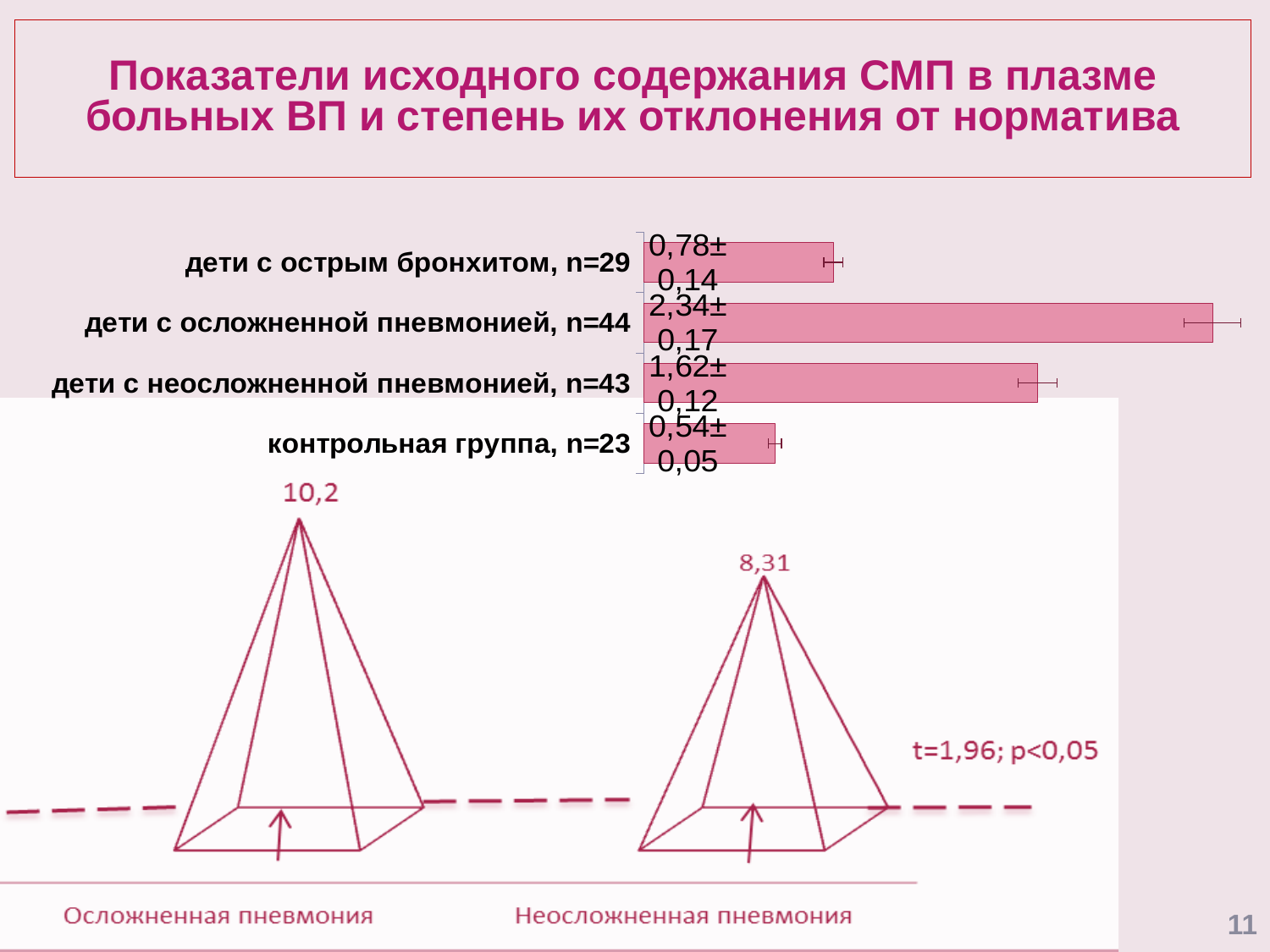
In the bar chart, which has the larger value: дети с острым бронхитом, n=29 or контрольная группа, n=23? дети с острым бронхитом, n=29 In the bar chart, what is the value shown for дети с неосложненной пневмонией, n=43? 1,62±0,12 In the bar chart, which group has the lowest value? контрольная группа, n=23 In the bar chart, what is the difference between the mean values for дети с острым бронхитом, n=29 and контрольная группа, n=23? 0,24 In the bar chart, what is the difference between the mean values for дети с осложненной пневмонией, n=44 and дети с неосложненной пневмонией, n=43? 0,72 In the bar chart, which group has the highest value? дети с осложненной пневмонией, n=44 What kind of chart is the upper chart on the slide? bar chart In the bar chart, what is the value shown for дети с острым бронхитом, n=29? 0,78±0,14 In the bar chart, what is the value shown for контрольная группа, n=23? 0,54±0,05 In the pyramid figure at the bottom of the slide, what value is shown above the pyramid labelled Осложненная пневмония? 10,2 In the bar chart, what is the value shown for дети с осложненной пневмонией, n=44? 2,34±0,17 How many groups (bars) are shown in the bar chart? 4